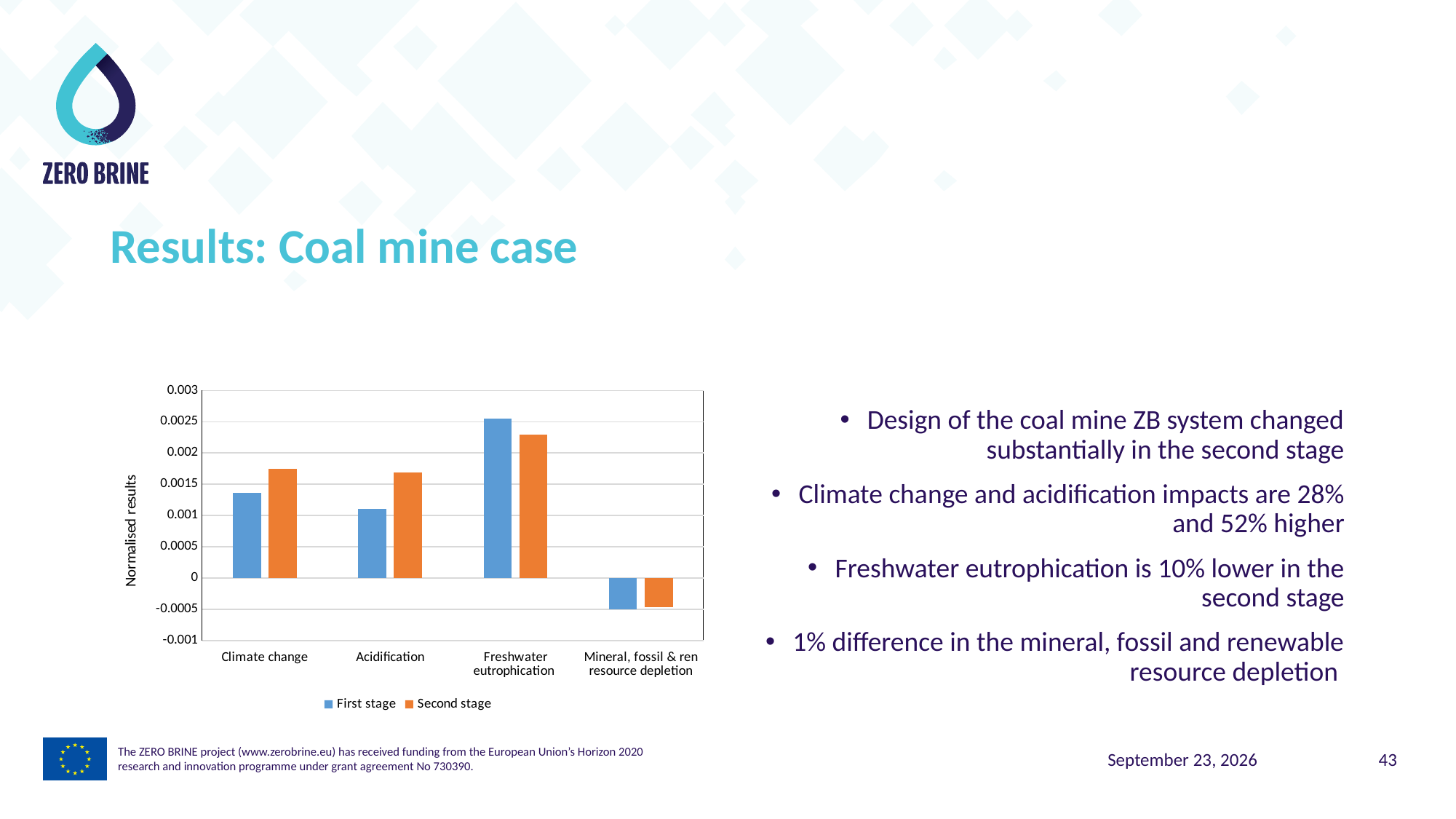
How many categories are shown on the x axis of the chart? 4 Which category has the lowest Second stage value? Mineral, fossil & ren resource depletion Is the First stage value for Mineral, fossil & ren resource depletion greater or less than 0? less What are the two series named in the chart legend? First stage and Second stage What is the label of the y axis of the chart? Normalised results Is the Second stage value for Acidification greater or less than 0.0015? greater How many series does the chart legend list? 2 What kind of chart is shown on the slide? bar chart For Climate change, which is larger: the First stage value or the Second stage value? Second stage Is the First stage value for Climate change greater or less than 0.001? greater For Freshwater eutrophication, which is larger: the First stage value or the Second stage value? First stage Which category has the highest First stage value? Freshwater eutrophication